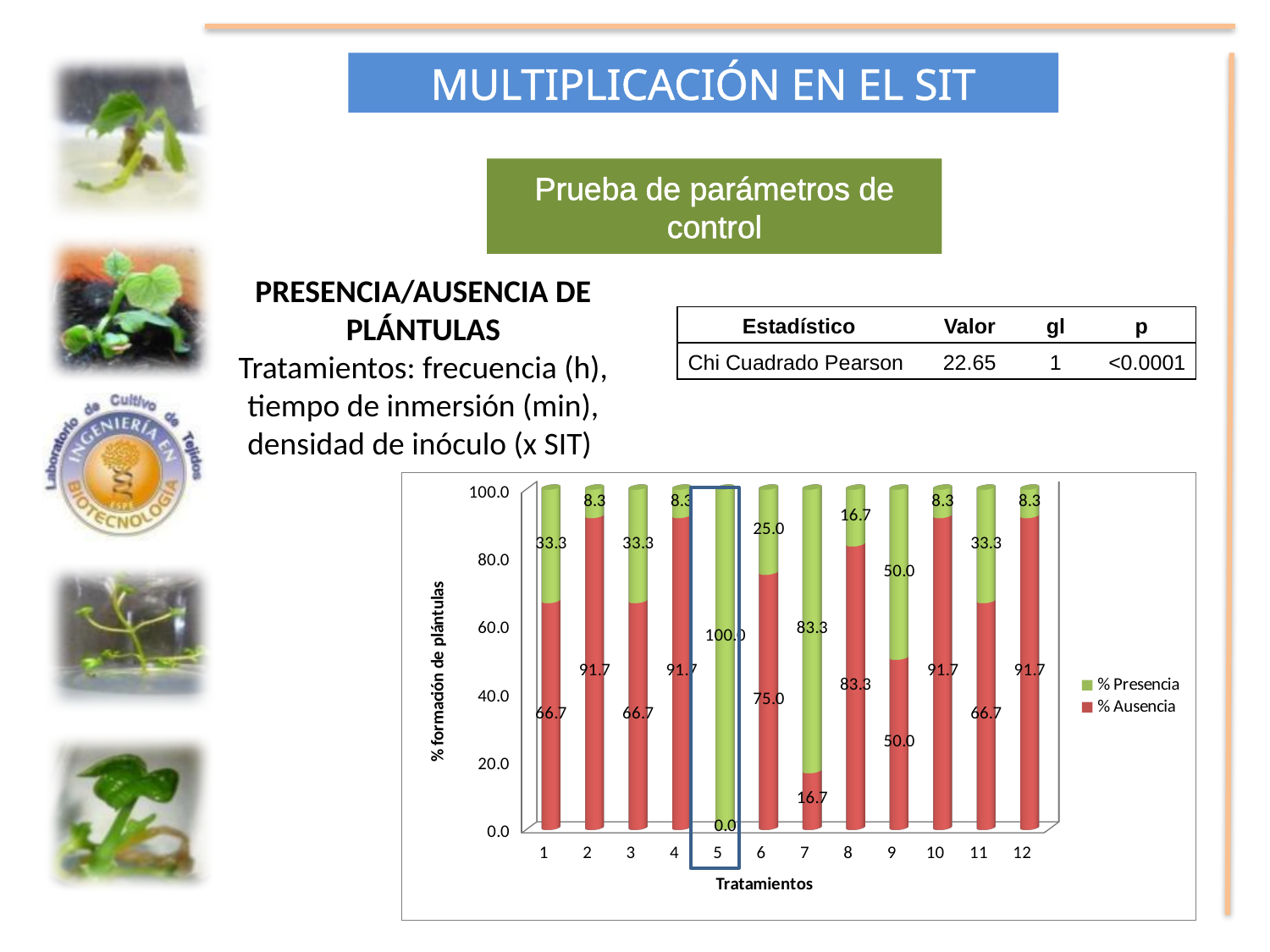
Which is larger, the % Presencia for treatment 7 or the % Presencia for treatment 8? treatment 7 What is the % Ausencia value for treatment 7? 16.7 What is the % Presencia value for treatment 9? 50.0 What is the total of the stacked bar for treatment 1 (% Presencia plus % Ausencia)? 100.0 What is the % Presencia value for treatment 5? 100.0 Which treatment has the highest % Presencia? 5 Which treatment has the lowest % Ausencia? 5 What type of chart is shown on the slide? stacked bar chart How many series does the chart legend list? 2 What is the difference between the % Ausencia of treatment 6 and the % Ausencia of treatment 7? 58.3 What is the label of the y axis of the chart? % formación de plántulas How many treatments (categories) are shown on the x axis of the chart? 12